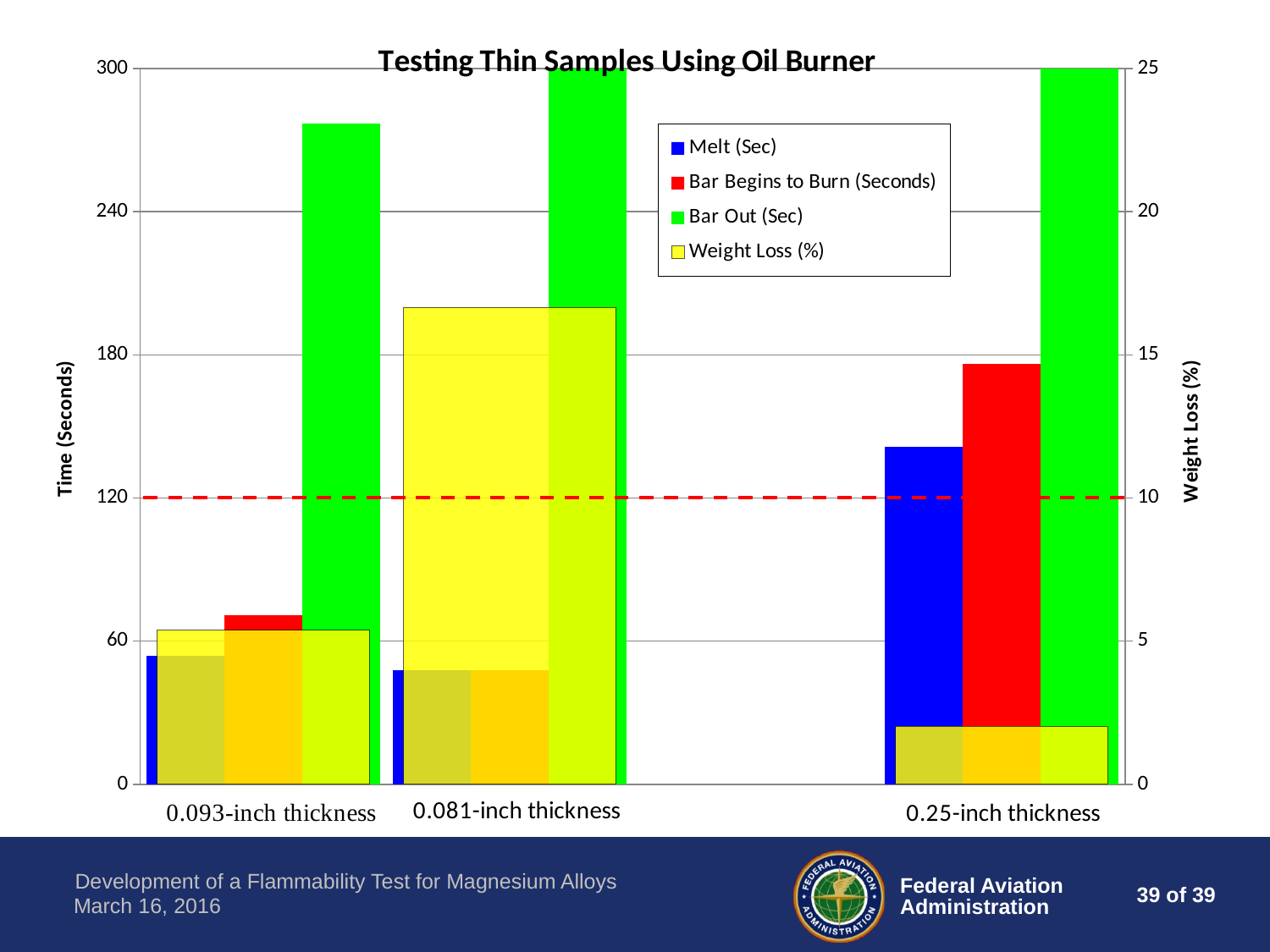
Is the Melt (Sec) value for 0.25-inch thickness greater or less than 120? greater Is the Weight Loss (%) value for 0.081-inch thickness greater or less than 15? greater What kind of chart is shown on the slide? bar chart Which has the larger Melt (Sec) value, 0.093-inch thickness or 0.25-inch thickness? 0.25-inch thickness How many thickness categories are shown on the x axis? 3 Is the Bar Out (Sec) value for 0.093-inch thickness greater or less than 240? greater How many series does the legend list? 4 What is the label of the right-hand vertical axis? Weight Loss (%) What is the title of the chart? Testing Thin Samples Using Oil Burner Which thickness has the highest Weight Loss (%)? 0.081-inch thickness